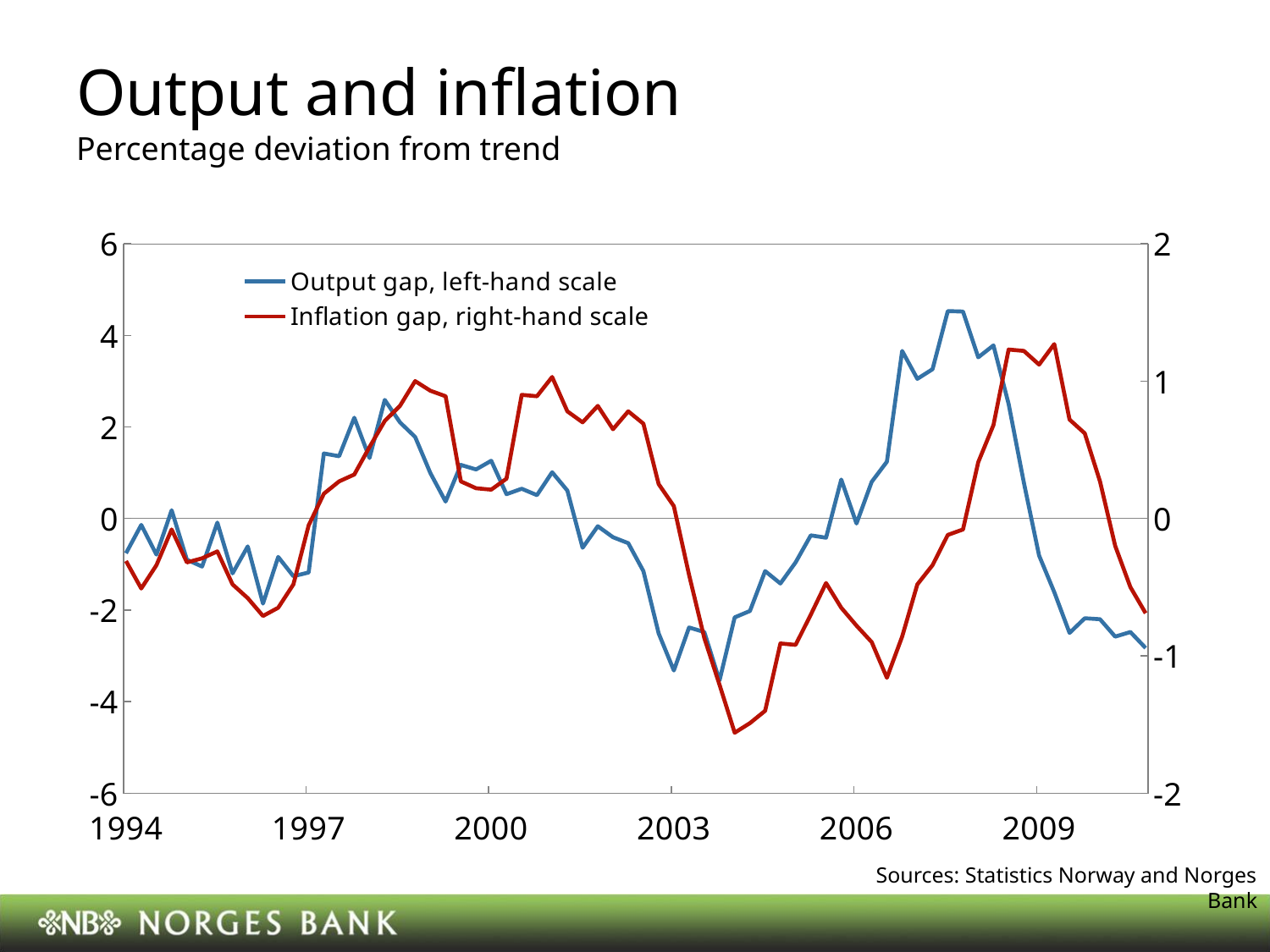
Is the value of the output gap at 1994 greater or less than 0? less Does the output gap rise or fall between 2006 and 2008? rise Does the inflation gap rise or fall from 2009 to the end of the series? fall Is the lowest value of the inflation gap, reached around 2004, greater or less than -1? less Which series is plotted on the right-hand scale? Inflation gap Is the value of the inflation gap at 2009 greater or less than 1? greater How many series does the legend list? 2 What is the title of the chart on the slide? Output and inflation Does the output gap rise or fall between 2003 and 2004? rise What kind of chart is shown on the slide? Line chart